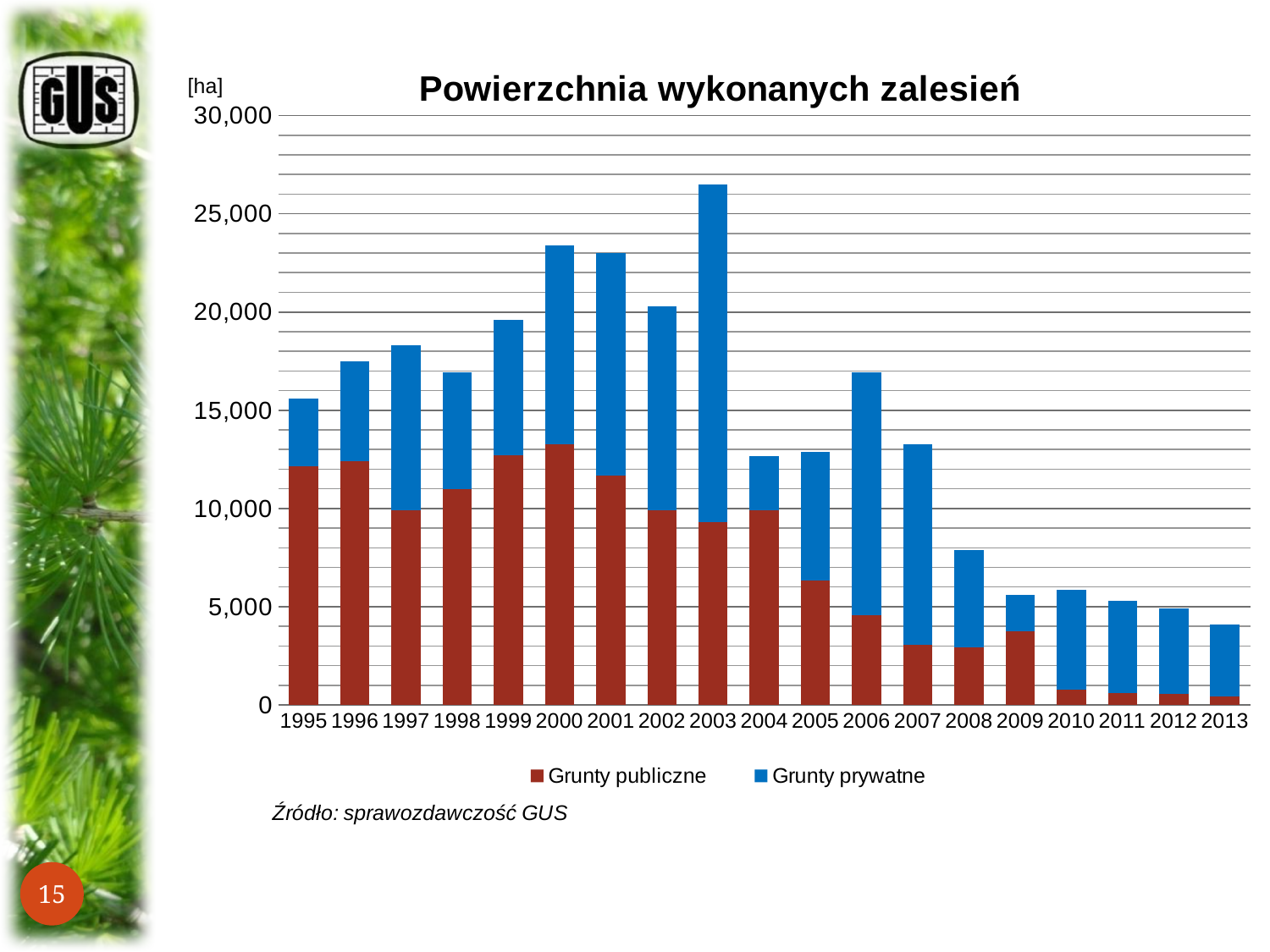
What kind of chart is shown on the slide? Stacked bar chart What is the title of the chart? Powierzchnia wykonanych zalesień How many series does the legend list? 2 How many years are shown on the x axis? 19 Is the Grunty publiczne value for 2000 greater or less than 10,000? greater Is the Grunty publiczne value for 2006 greater or less than 5,000? less Is the total value for 2003 greater or less than 25,000? greater Which year has the lowest total bar? 2013 Do the total bars generally rise or fall from 2003 to 2013? fall Which year has the highest total bar? 2003 Which year has the larger total bar, 1995 or 2013? 1995